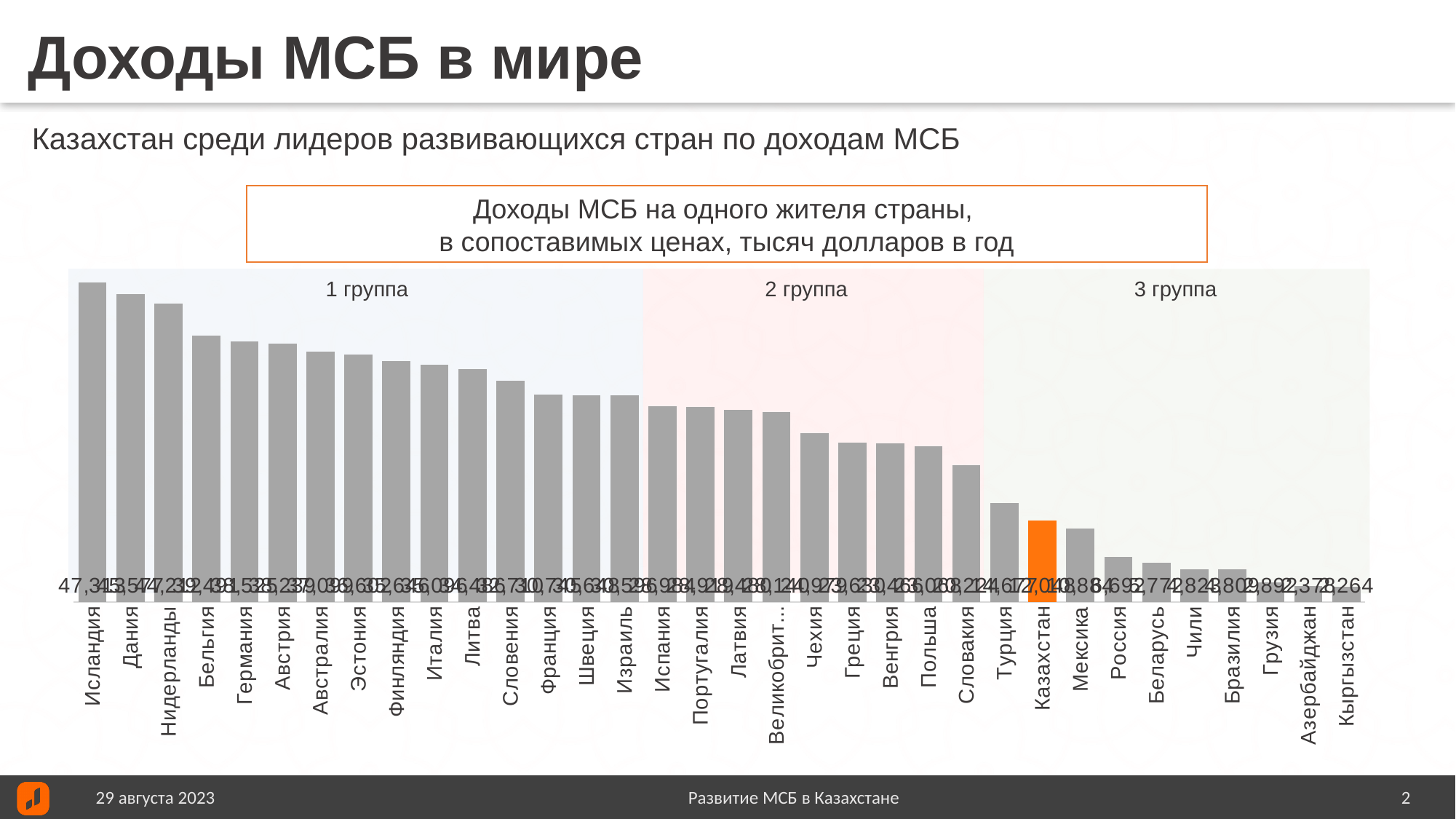
Which has a larger value, Дания or Бельгия? Дания Do the values rise or fall from left to right along the x axis? fall What is the value shown for Кыргызстан? 2,264 What kind of chart is shown on the slide? bar chart Which country has the highest value in the chart? Исландия Which has a larger value, Казахстан or Мексика? Казахстан Which country has the lowest value in the chart? Кыргызстан How many countries are shown in the chart? 34 How many groups (группа) is the chart divided into? 3 What is the value shown for Исландия? 47,313 Which country's bar is highlighted in orange? Казахстан Which has a larger value, Турция or Казахстан? Турция